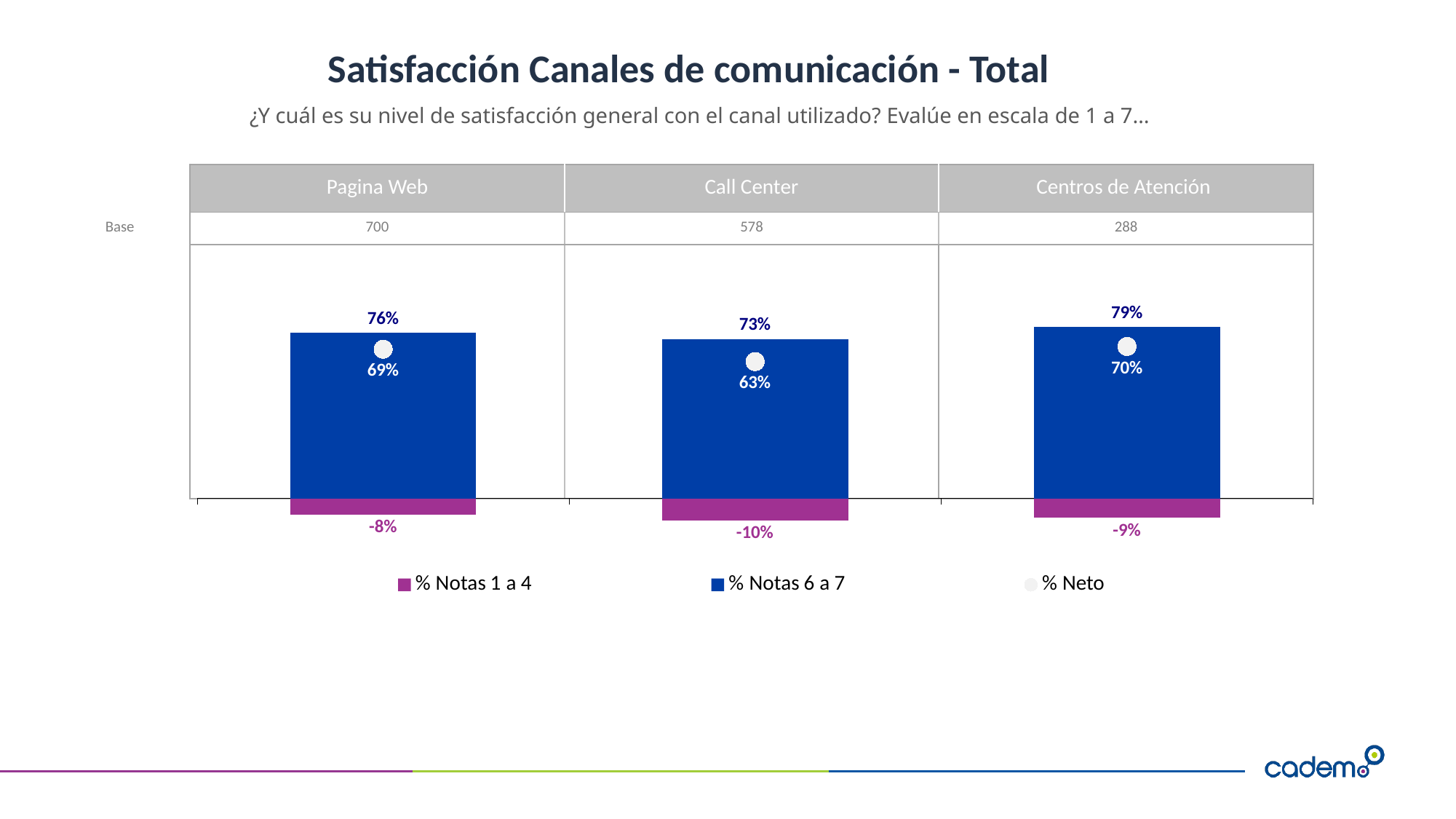
How many channels (categories) are shown in the chart? 3 What is the base (sample size) shown for Call Center? 578 What is the % Notas 1 a 4 value for Call Center? -10% What is the % Neto value for Call Center? 63% Which channel has the highest % Notas 6 a 7 value? Centros de Atención What is the % Neto value for Centros de Atención? 70% Which is larger, the % Neto value for Pagina Web or for Centros de Atención? Centros de Atención What is the difference between the % Notas 6 a 7 values for Centros de Atención and Call Center? 6% How many series does the legend list? 3 What is the % Notas 6 a 7 value for Pagina Web? 76% Which channel has the lowest % Neto value? Call Center What kind of chart is shown on the slide? Bar chart